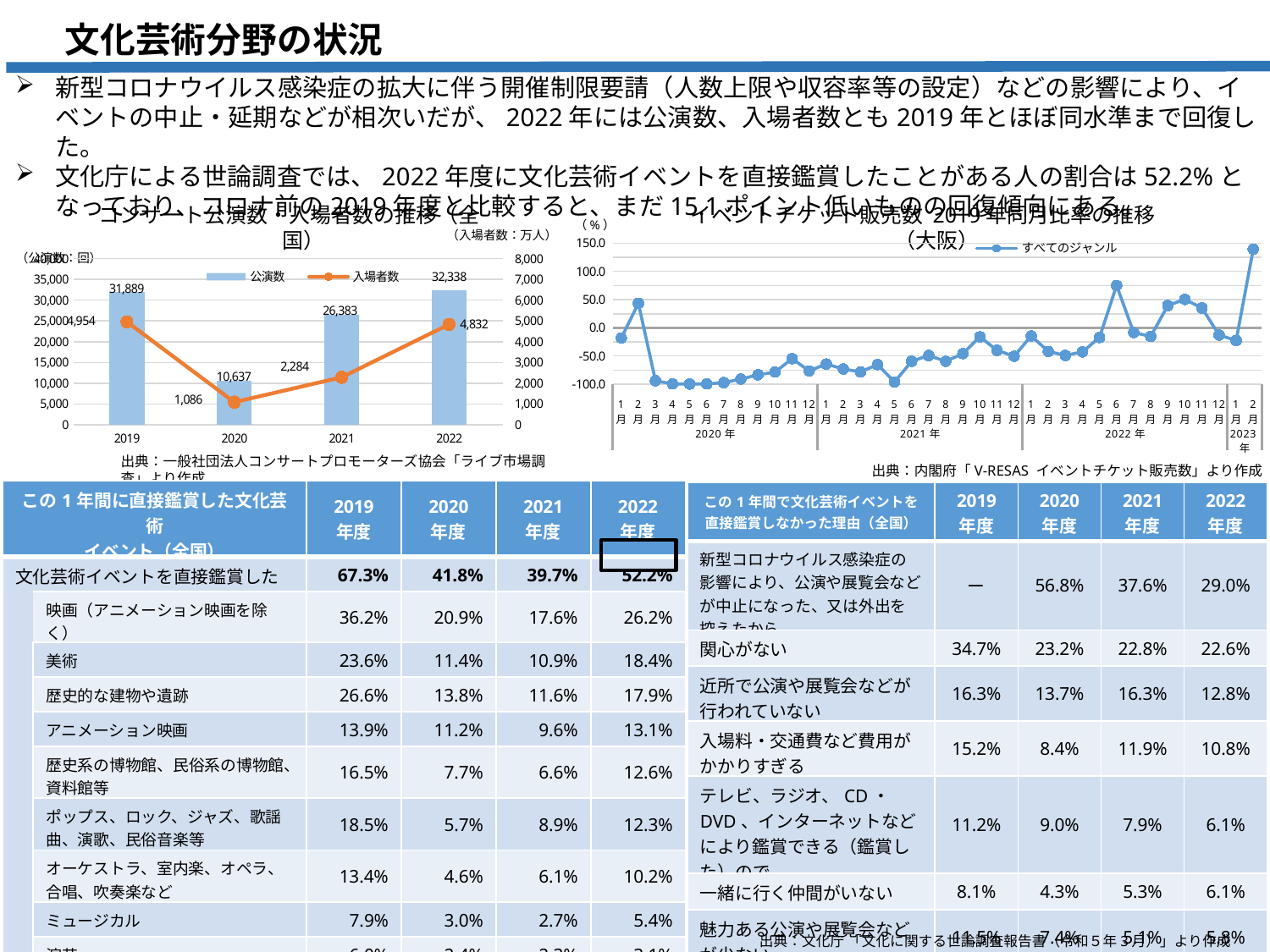
In the left chart (コンサート公演数・入場者数の推移), which year has the lowest 入場者数? 2020 In the left chart (コンサート公演数・入場者数の推移), which year has the larger 入場者数, 2019 or 2022? 2019 In the right chart (イベントチケット販売数 2019年同月比率の推移（大阪）), is the value for 2020年3月 greater or less than -50.0? less In the left chart (コンサート公演数・入場者数の推移), how many series does the legend list? 2 In the left chart (コンサート公演数・入場者数の推移), which year has the highest 公演数? 2022 In the left chart (コンサート公演数・入場者数の推移), what is the difference between the 公演数 for 2022 and 2019? 449 In the left chart (コンサート公演数・入場者数の推移), what is the difference between the 入場者数 for 2022 and 2021? 2,548 In the left chart (コンサート公演数・入場者数の推移), what is the 入場者数 value for 2020? 1,086 What kind of chart is the right chart (イベントチケット販売数 2019年同月比率の推移（大阪）)? line chart In the left chart (コンサート公演数・入場者数の推移), do the 公演数 values rise or fall from 2020 to 2022? rise In the left chart (コンサート公演数・入場者数の推移), how many years are shown on the x axis? 4 In the left chart (コンサート公演数・入場者数の推移), what is the 公演数 value for 2019? 31,889